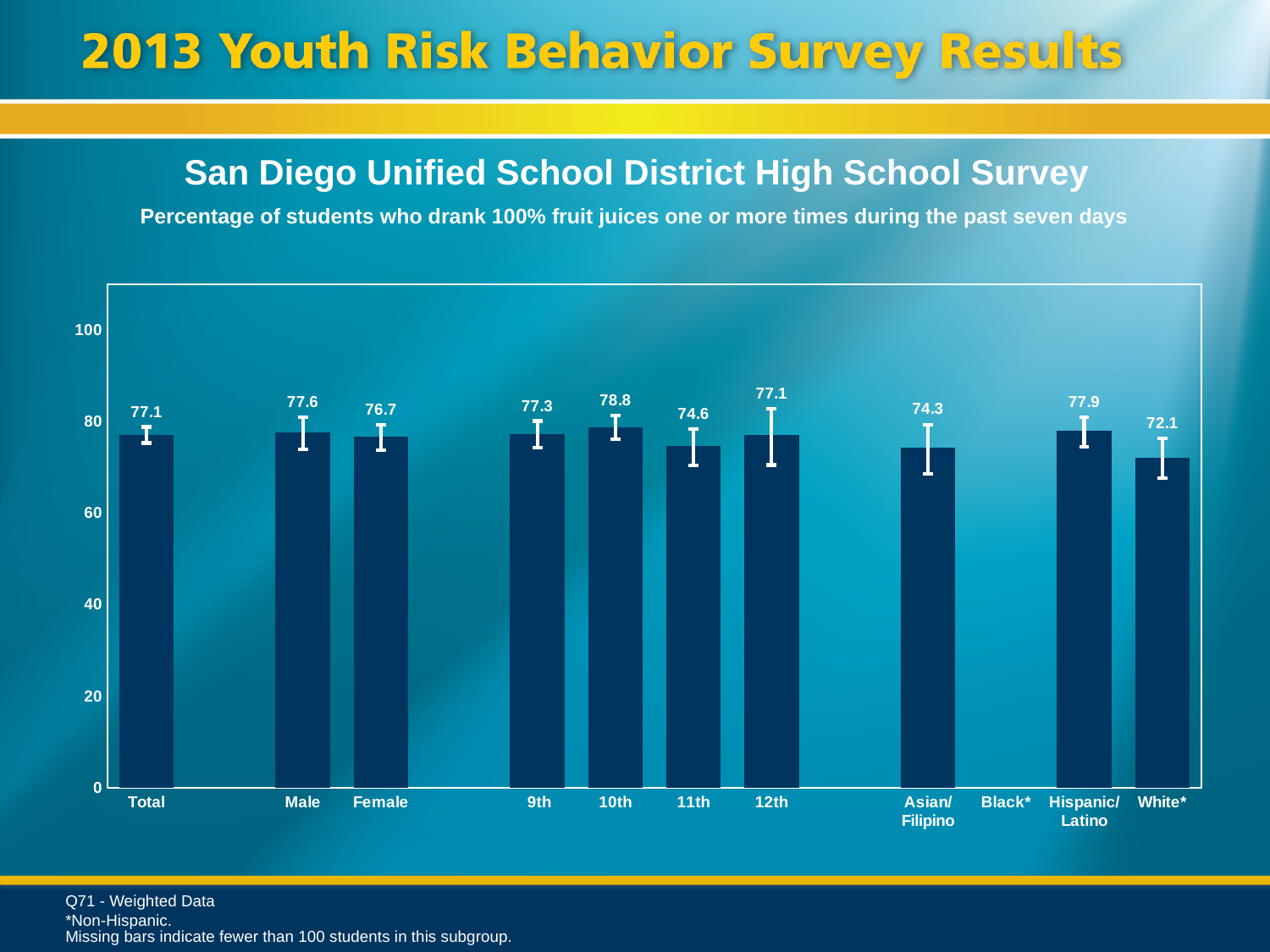
What is the value for White* students? 72.1 What is the value for 10th grade students? 78.8 What kind of chart is shown on the slide? bar chart Which category has the highest value? 10th What is the value for Total? 77.1 What is the difference between the 10th and 11th grade values? 4.2 What is the value for Asian/Filipino students? 74.3 Which category label on the x axis has no bar plotted? Black* Which is larger, the value for Hispanic/Latino or the value for White*? Hispanic/Latino Is the value for 11th grade greater or less than 80? less Which category with a plotted bar has the lowest value? White* What is the difference between the Male and Female values? 0.9